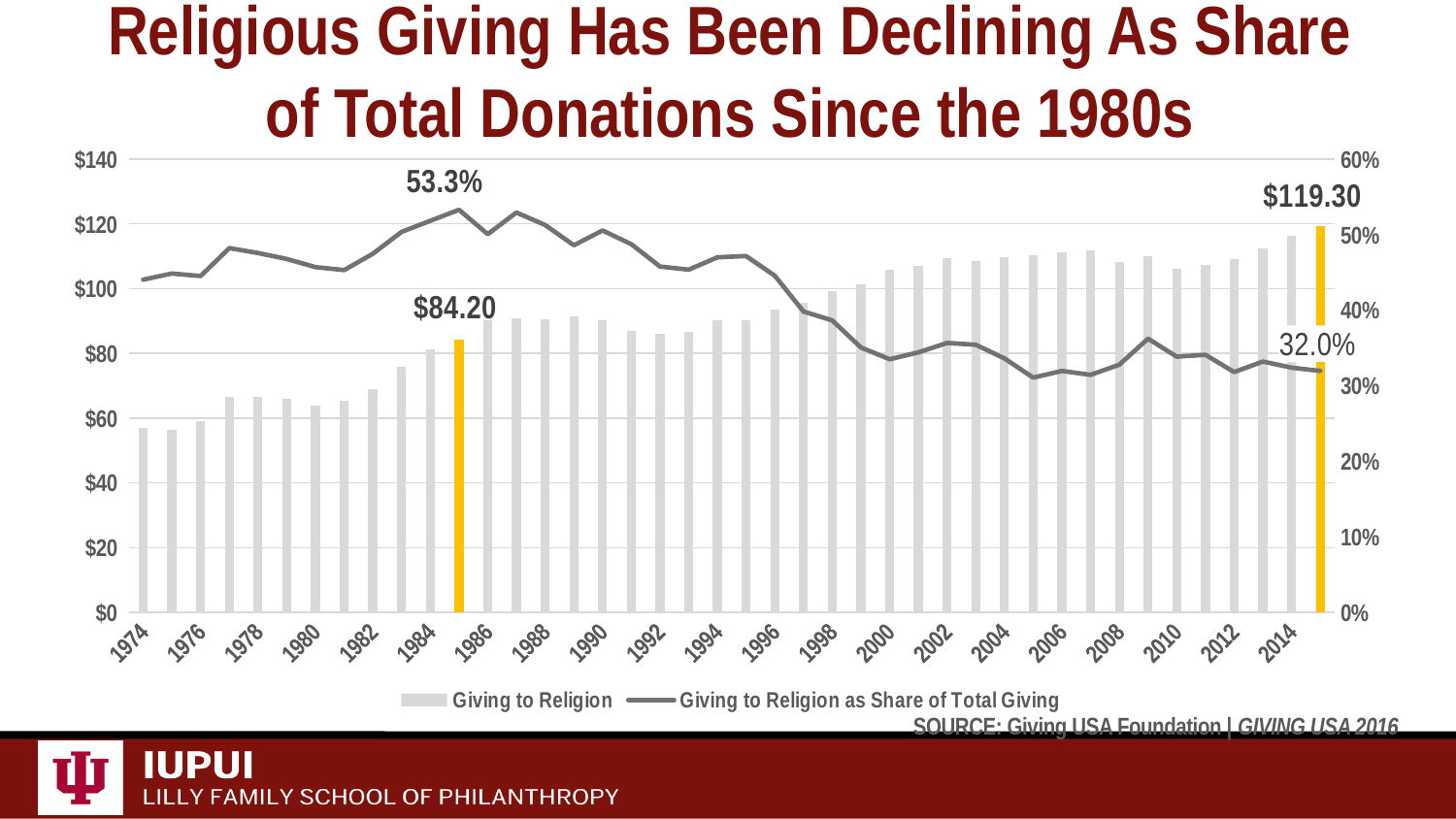
How much larger is the labeled Giving to Religion value for 2015 than for 1985? $35.10 Which is larger, the Giving to Religion bar for 1985 or for 2015? 2015 Does Giving to Religion as Share of Total Giving rise or fall from 1985 to 2015? fall What is the value of Giving to Religion in 2015, the last bar on the chart? $119.30 What is the labeled value of Giving to Religion as Share of Total Giving in 2015? 32.0% Is the Giving to Religion value for 2000 greater or less than $100? greater Is the Giving to Religion value for 1974 greater or less than $60? less What was Giving to Religion as Share of Total Giving at its labeled peak in 1985? 53.3% By how many percentage points did Giving to Religion as Share of Total Giving fall between its labeled 1985 value and its labeled 2015 value? 21.3 percentage points What is the value of Giving to Religion in 1985? $84.20 Which year has the highest value for Giving to Religion as Share of Total Giving? 1985 How many series does the legend list? 2